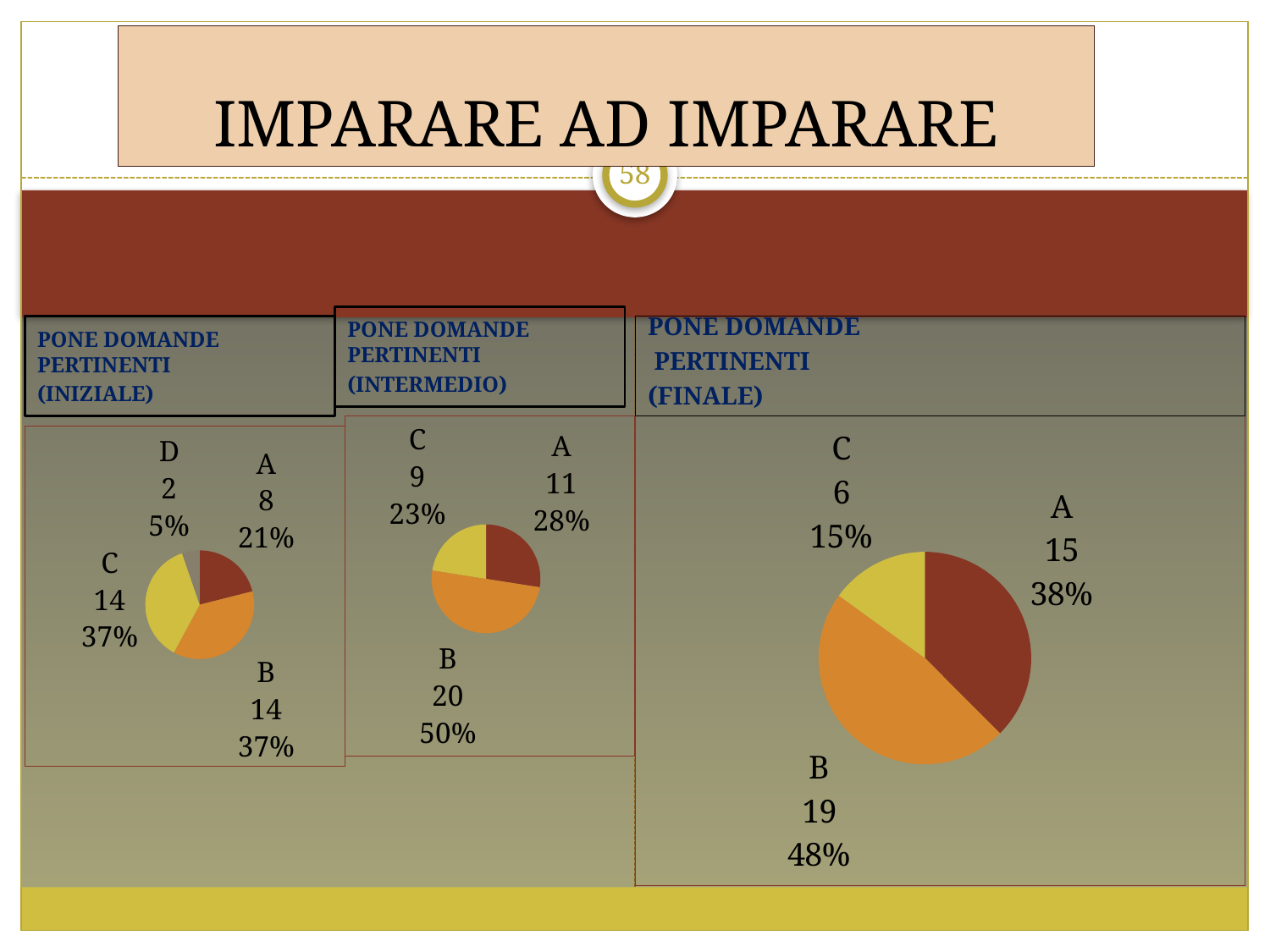
What type of chart is used in the PONE DOMANDE PERTINENTI (FINALE) panel? pie chart In the PONE DOMANDE PERTINENTI (INTERMEDIO) chart, what is the difference between the values for B and A? 9 In the PONE DOMANDE PERTINENTI (INIZIALE) chart, what percentage share does category D have? 5% In the PONE DOMANDE PERTINENTI (FINALE) chart, what is the value for category C? 6 In the PONE DOMANDE PERTINENTI (FINALE) chart, which is larger, the value for A or the value for B? B In the PONE DOMANDE PERTINENTI (INTERMEDIO) chart, what is the value for category B? 20 How many categories are shown in the PONE DOMANDE PERTINENTI (FINALE) pie chart? 3 In the PONE DOMANDE PERTINENTI (INTERMEDIO) chart, which category has the highest value? B In the PONE DOMANDE PERTINENTI (INTERMEDIO) chart, what percentage share does category C have? 23% In the PONE DOMANDE PERTINENTI (INIZIALE) chart, what is the value for category A? 8 In the PONE DOMANDE PERTINENTI (INIZIALE) chart, which category has the lowest value? D How many categories are shown in the PONE DOMANDE PERTINENTI (INIZIALE) pie chart? 4